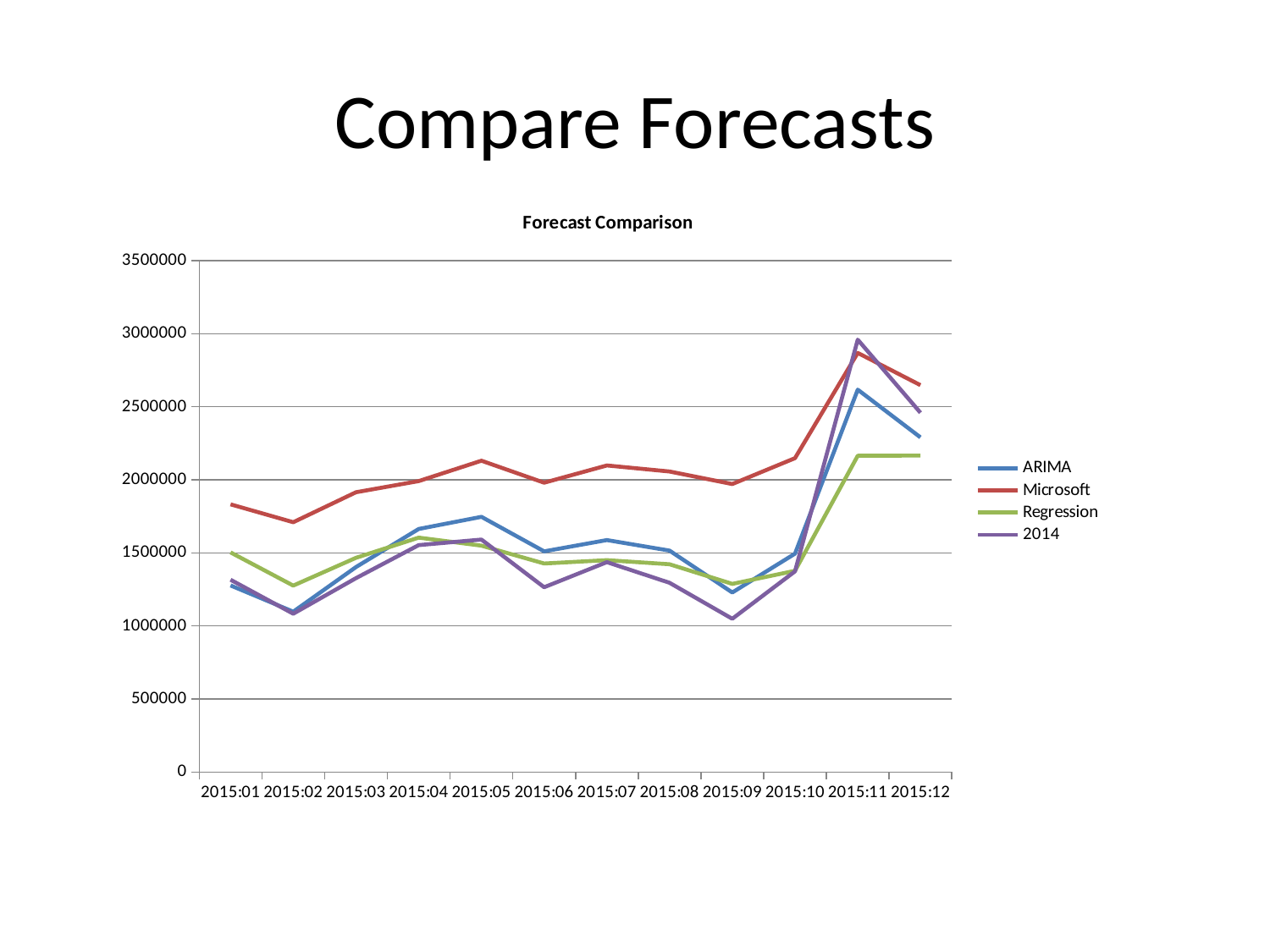
Is the value for Microsoft at 2015:01 greater or less than 1500000? greater How many points are plotted along the x axis for each series? 12 Is the value for Regression at 2015:02 greater or less than 1500000? less At which month does the Microsoft series reach its highest value? 2015:11 What is the title of the chart? Forecast Comparison How many series does the legend list? 4 Which series has the highest value at 2015:01? Microsoft Is the value for ARIMA at 2015:11 greater or less than 2500000? greater Which series is shown in red? Microsoft Which series has the lowest value at 2015:11? Regression What kind of chart is shown on the slide? line chart